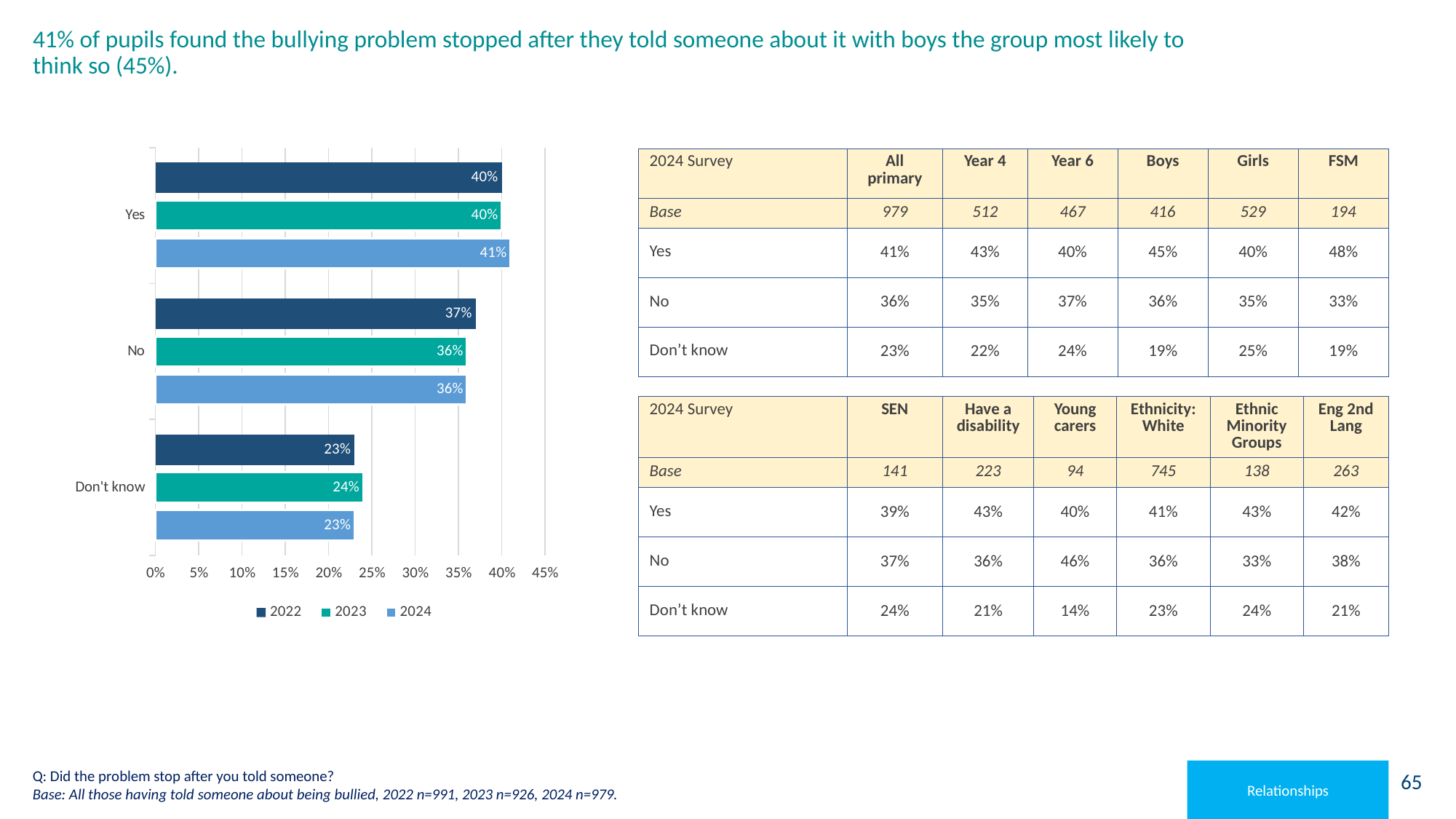
Which series is shown in the lightest blue colour in the legend? 2024 Which category has the highest value in the 2022 series? Yes What is the value for 'Don't know' in the 2023 series? 24% Is the value for 'No' in the 2023 series greater or less than 40%? less How many series does the legend list? 3 What kind of chart is shown on the slide? Bar chart What is the difference between the 'Yes' and 'No' values in the 2024 series? 5 percentage points Which is larger in the 2023 series: 'Yes' or 'Don't know'? Yes Which category has the lowest value in the 2024 series? Don't know How many categories are shown on the chart? 3 What is the value for 'No' in the 2022 series? 37% What is the value for 'Yes' in the 2024 series? 41%